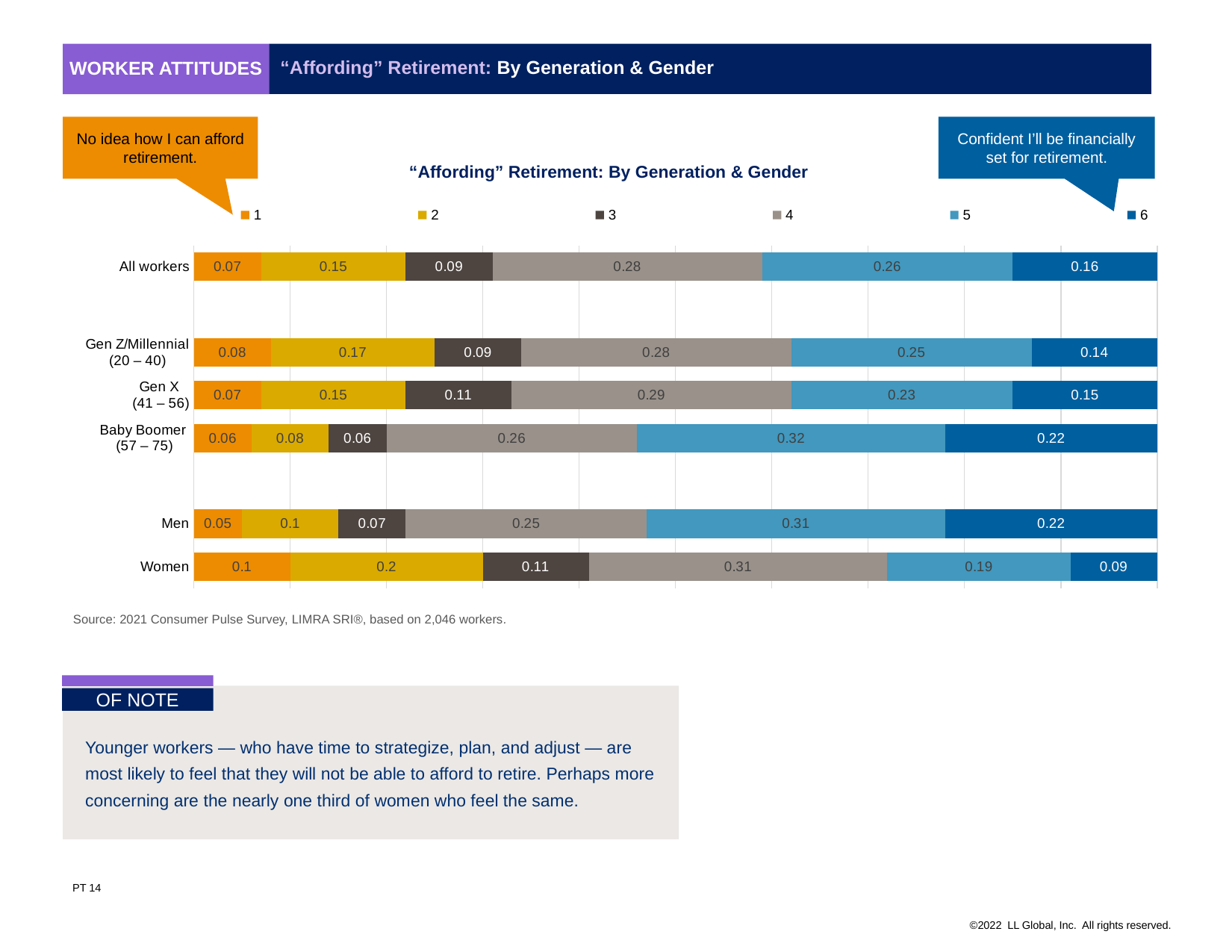
What is the value for series 4 in the All workers bar? 0.28 How many categories are shown on the y axis of the chart? 6 How many series does the legend list? 6 Which category has the lowest value for series 6? Women Which has the larger series 2 value, Gen Z/Millennial (20 – 40) or Gen X (41 – 56)? Gen Z/Millennial (20 – 40) What is the value for series 6 in the Baby Boomer (57 – 75) bar? 0.22 What is the value for series 5 in the Men bar? 0.31 Which category has the highest value for series 1? Women What is the difference between the series 5 values for Baby Boomer (57 – 75) and Gen X (41 – 56)? 0.09 What is the difference between the series 1 values for Women and Men? 0.05 What kind of chart is shown on the slide? Stacked bar chart What is the value for series 2 in the Women bar? 0.2